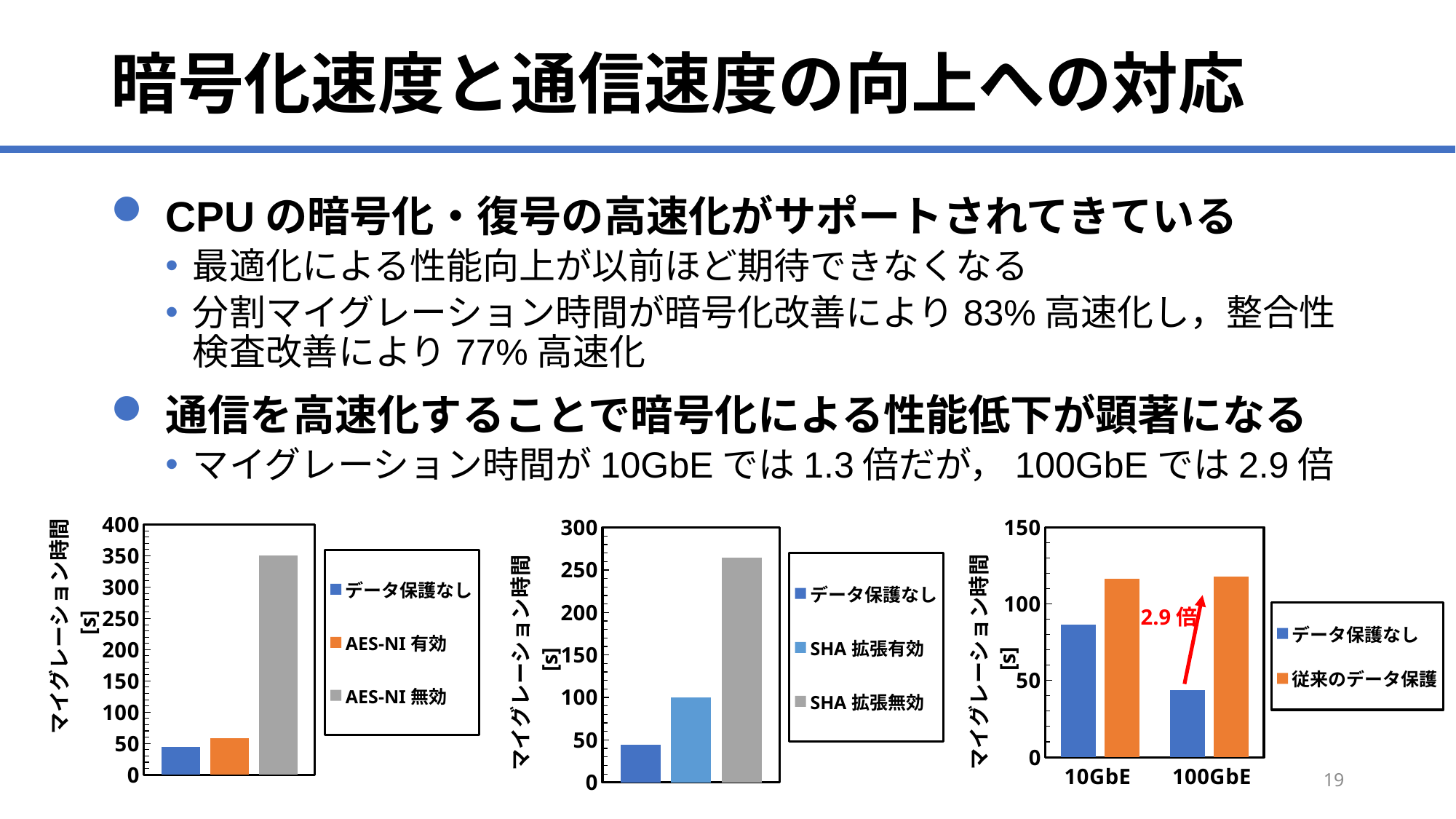
In the left chart, is the value for AES-NI 有効 greater or less than 100? less In the middle chart, is the value for SHA 拡張無効 greater or less than 250? greater In the left chart, which series has the highest migration time? AES-NI 無効 In the left chart, how many series does the legend list? 3 In the right chart, is the value for データ保護なし at 100GbE greater or less than 50? less In the left chart, what kind of chart is it? bar chart In the left chart, which series has the lowest migration time? データ保護なし In the middle chart, which is larger, SHA 拡張有効 or データ保護なし? SHA 拡張有効 In the middle chart, which series has the highest migration time? SHA 拡張無効 In the right chart, how many categories are shown on the x axis? 2 In the right chart, what ratio is written in the red annotation? 2.9 倍